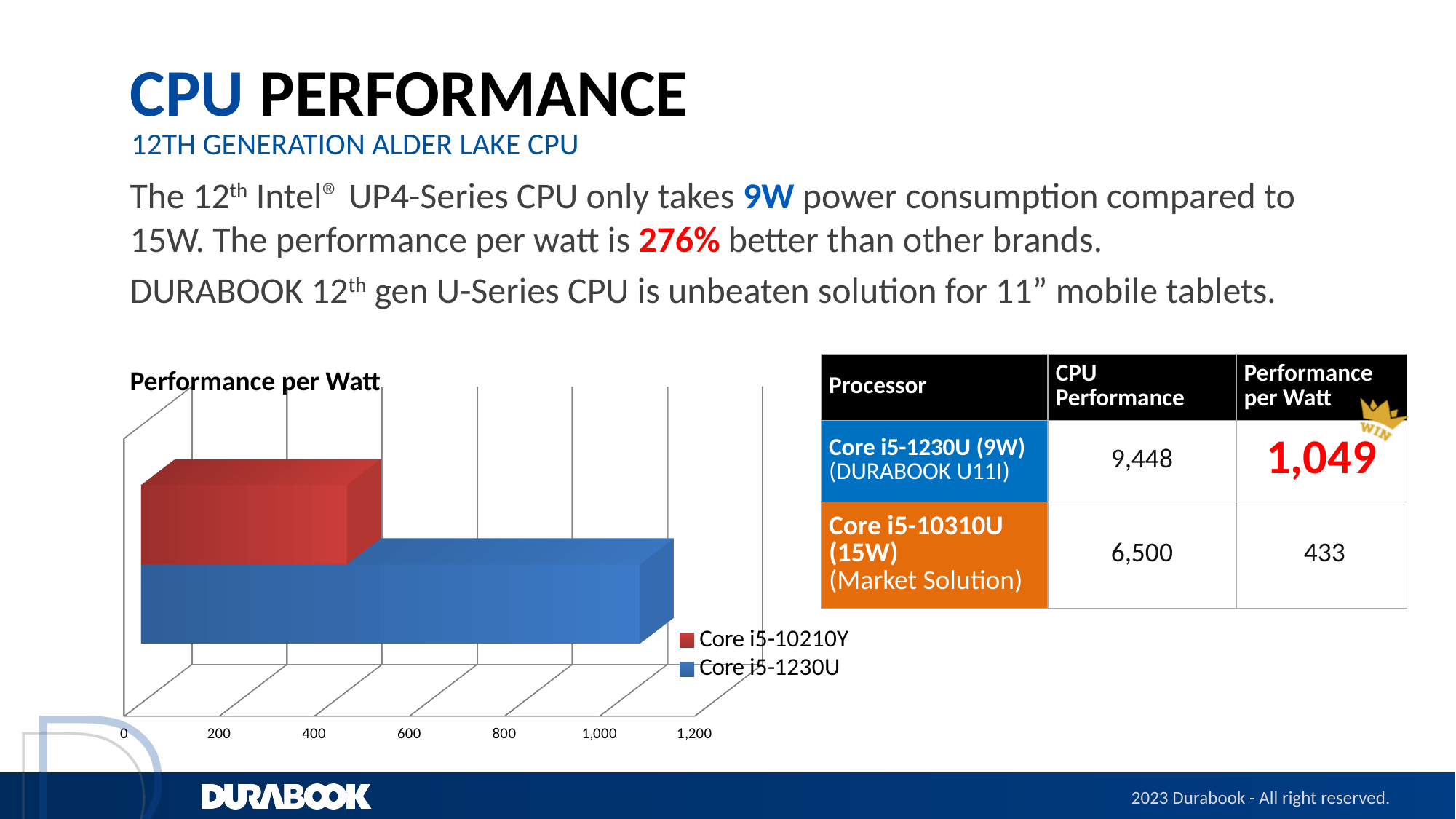
Is the value for Core i5-1230U greater or less than 1,200? less Is the value for Core i5-1230U greater or less than 800? greater How many bars are plotted in the chart? 2 Is the value for Core i5-10210Y greater or less than 600? less What kind of chart is shown on the slide? bar chart What is the title of the chart? Performance per Watt How many series does the chart legend list? 2 Which series has the highest value in the chart? Core i5-1230U Which series has the lowest value in the chart? Core i5-10210Y Which has the larger value in the chart, Core i5-1230U or Core i5-10210Y? Core i5-1230U What colour is the bar for Core i5-1230U in the chart? blue